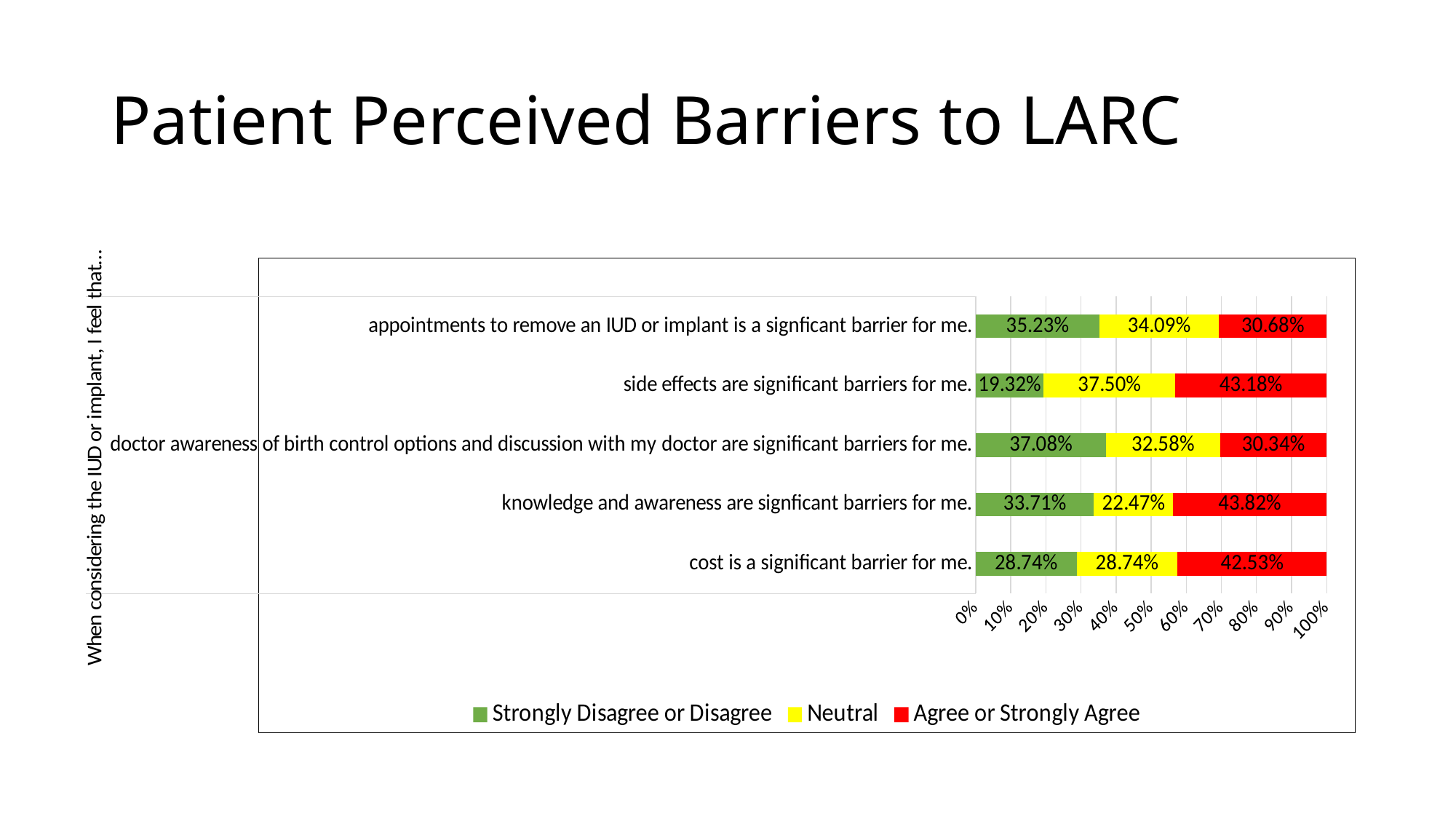
Which colour represents the Neutral series in the chart? Yellow For the cost statement, which is larger: the Agree or Strongly Agree share or the Neutral share? Agree or Strongly Agree Which statement has the lowest Strongly Disagree or Disagree percentage? side effects are significant barriers for me. Which statement has the highest Agree or Strongly Agree percentage? knowledge and awareness are signficant barriers for me. Which statement has the highest Neutral percentage? side effects are significant barriers for me. How many statements (categories) are shown in the chart? 5 What percentage of patients agreed or strongly agreed that side effects are significant barriers? 43.18% How many series does the legend list? 3 What kind of chart is shown on the slide? Stacked bar chart For the side effects statement, what is the difference between the Agree or Strongly Agree and the Strongly Disagree or Disagree percentages? 23.86 percentage points What percentage strongly disagreed or disagreed that doctor awareness of birth control options and discussion with my doctor are significant barriers? 37.08% What is the Neutral value for the statement that cost is a significant barrier? 28.74%